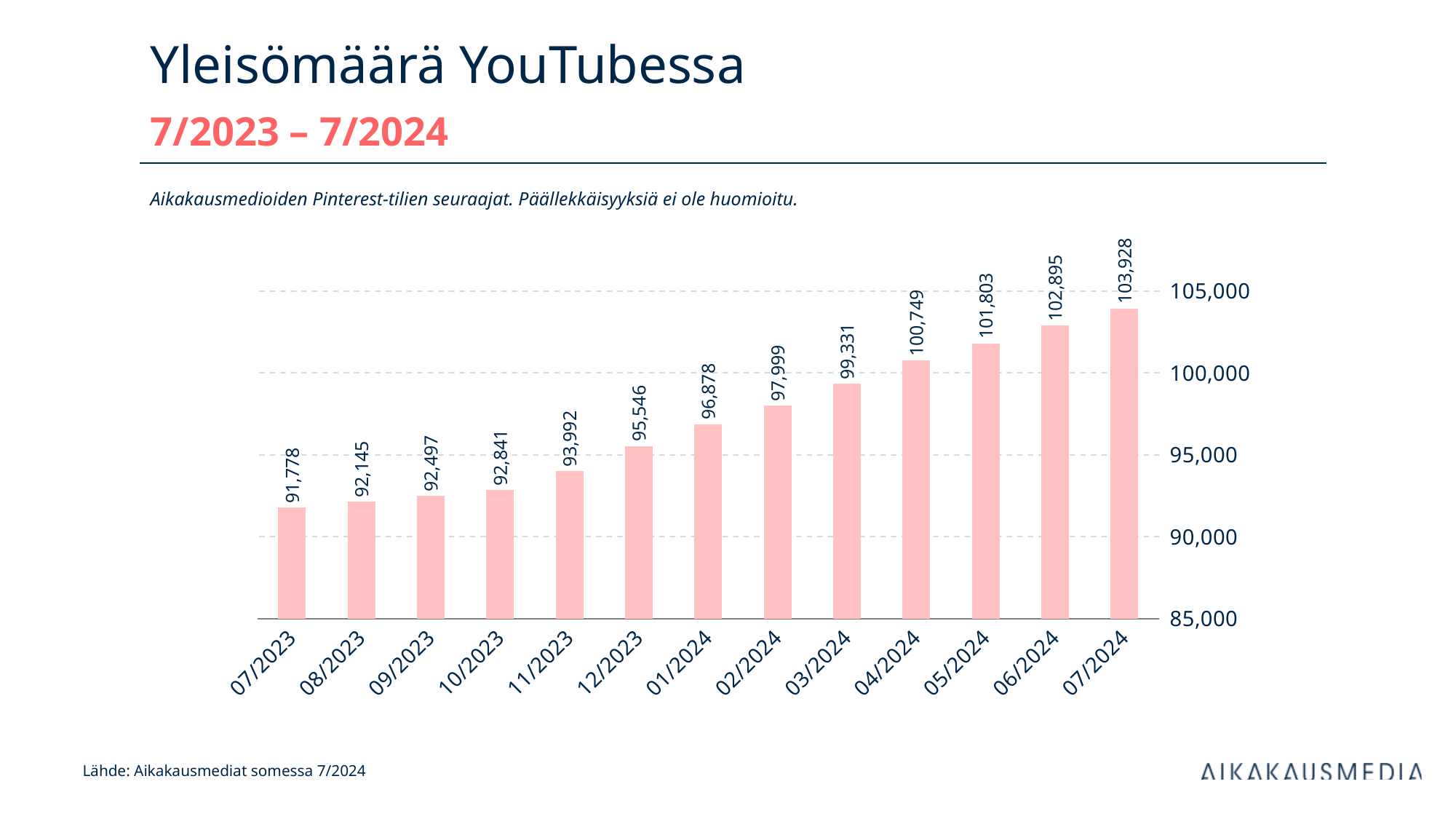
What is the value for 04/2024? 100,749 Do the values rise or fall from 07/2023 to 07/2024? rise What is the value for 07/2023? 91,778 Which is larger, the value for 03/2024 or the value for 11/2023? 03/2024 What is the difference between the values for 07/2024 and 07/2023? 12,150 Which month has the highest value? 07/2024 Which month has the lowest value? 07/2023 How many months are shown on the x axis? 13 What is the value for 01/2024? 96,878 Is the value for 02/2024 greater or less than 100,000? less What is the difference between the values for 01/2024 and 12/2023? 1,332 What kind of chart is shown on the slide? bar chart